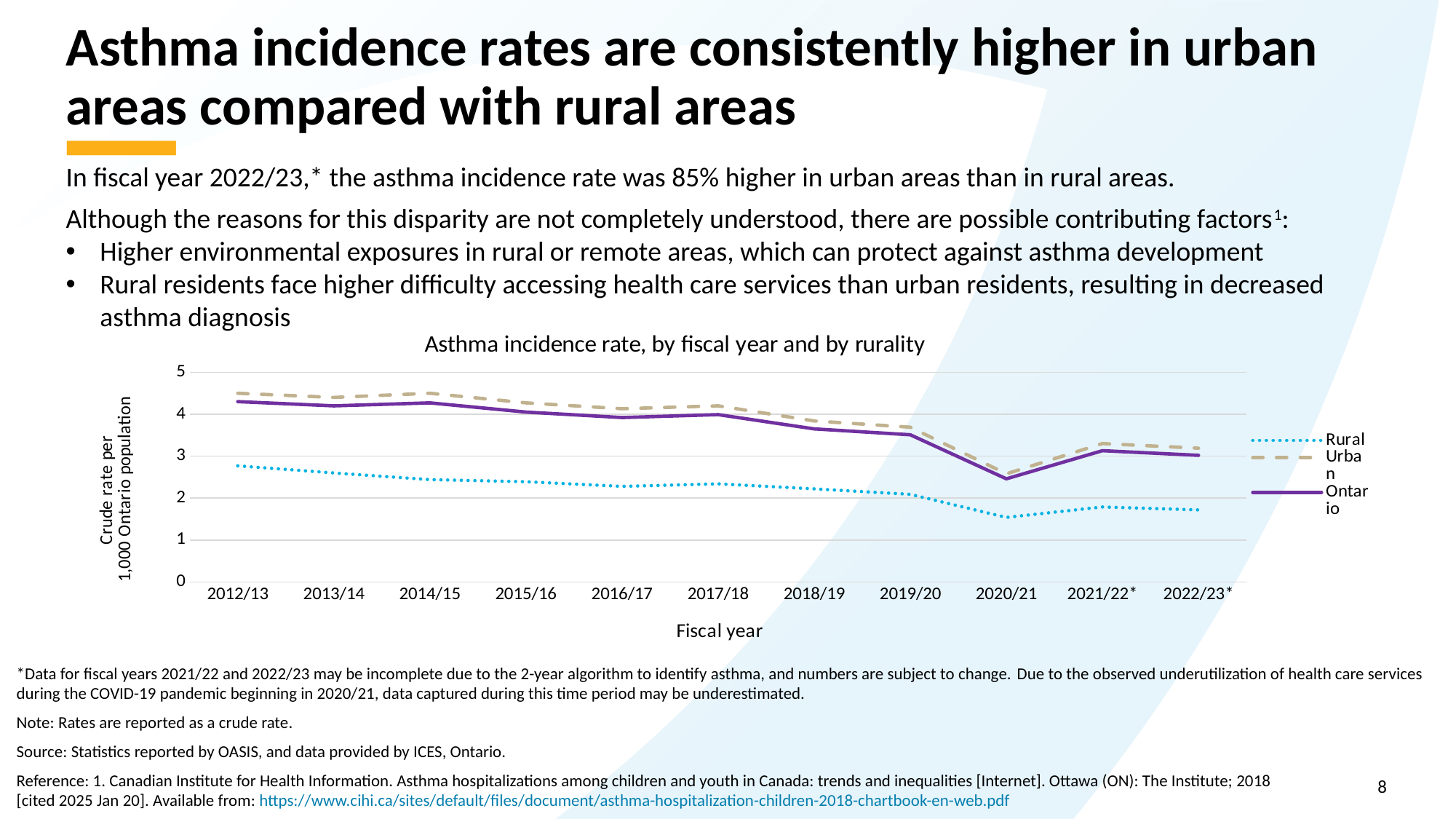
What kind of chart is shown on the slide? Line chart What is the label of the vertical axis? Crude rate per 1,000 Ontario population How many series does the chart's legend list? 3 Is the Rural value for 2020/21 greater or less than 2? less Is the Ontario value for 2020/21 greater or less than 3? less In 2012/13, which series has the larger value, Urban or Rural? Urban How many fiscal years are plotted along the x axis? 11 What is the title of the chart? Asthma incidence rate, by fiscal year and by rurality Is the Urban value for 2012/13 greater or less than 4? greater In which fiscal year is the Rural series at its lowest? 2020/21 Does the Rural series generally rise or fall from 2012/13 to 2022/23? Fall